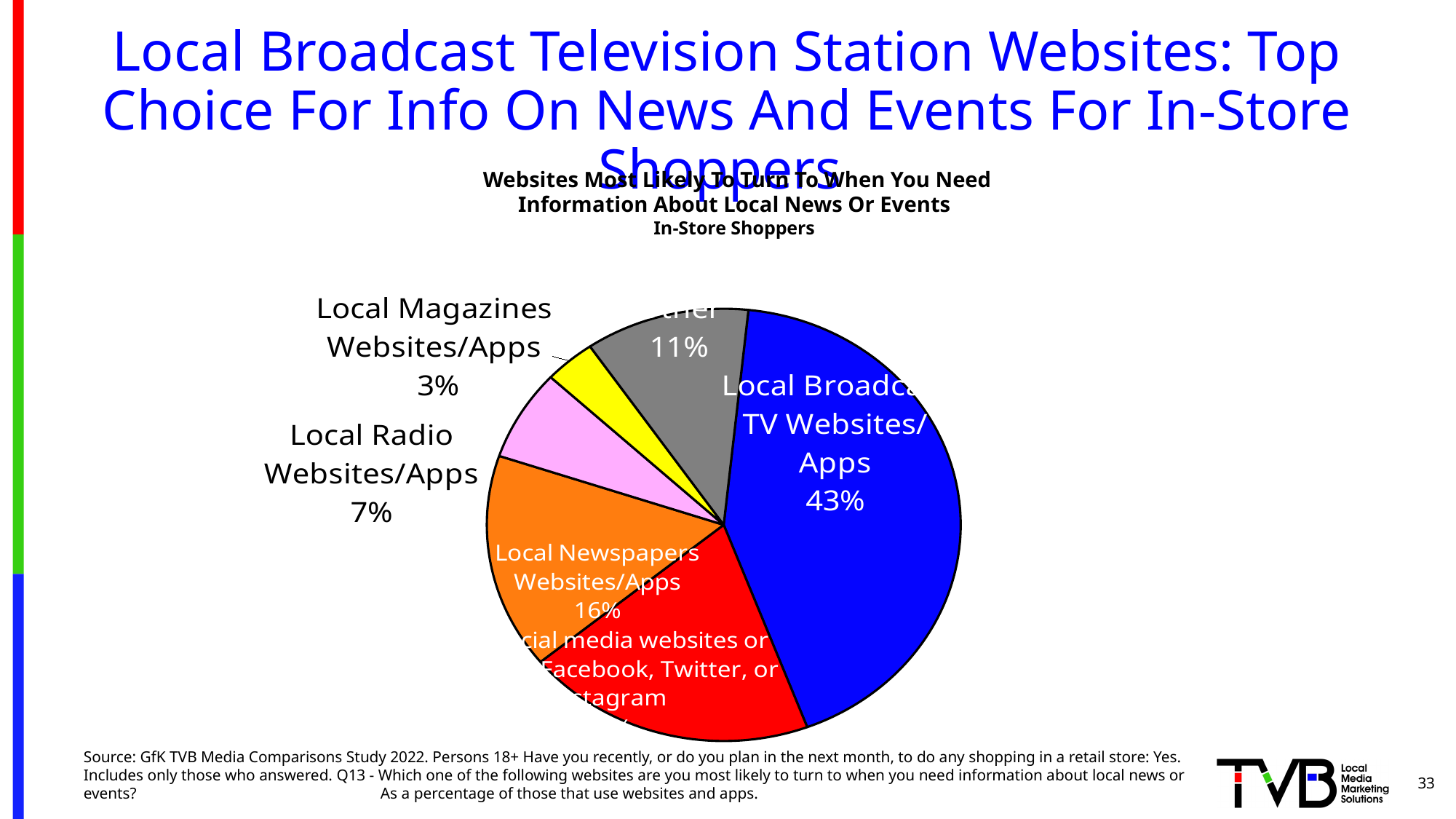
What share of the pie is Local Radio Websites/Apps? 7% What share of the pie is Local Newspapers Websites/Apps? 16% How many percentage points larger is Local Broadcast TV Websites/Apps than Local Newspapers Websites/Apps? 27 What share of the pie is Local Broadcast TV Websites/Apps? 43% How many slices does the pie chart have? 6 What kind of chart is shown on the slide? pie chart What share of the pie is the Other slice? 11% Which is larger: the Other slice or the Local Radio Websites/Apps slice? Other What share of the pie is Local Magazines Websites/Apps? 3% Which category has the largest slice of the pie? Local Broadcast TV Websites/Apps Which category has the smallest slice of the pie? Local Magazines Websites/Apps What colour is the Local Broadcast TV Websites/Apps slice? blue